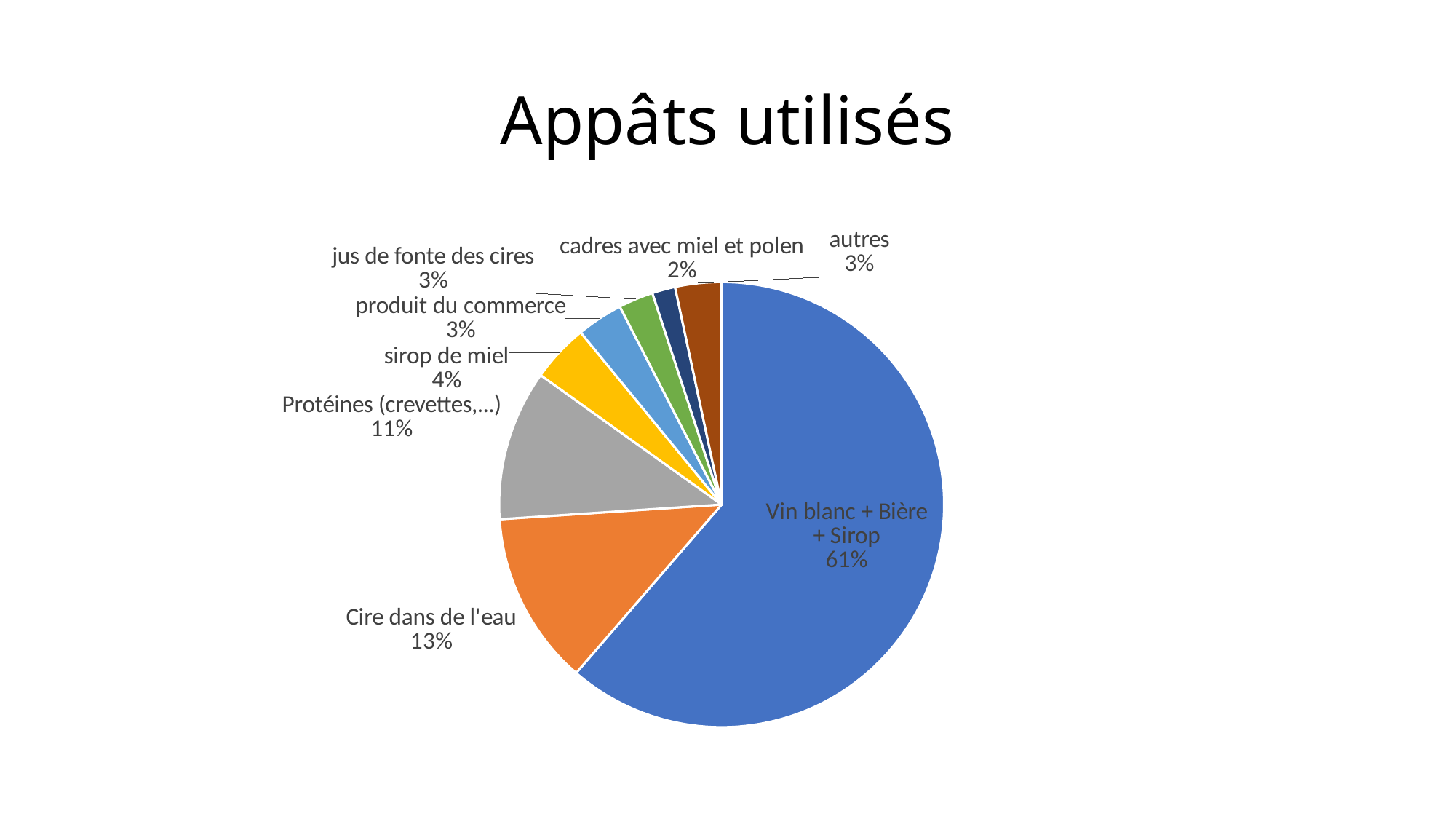
What kind of chart is shown on the slide? pie chart Which category has the largest slice of the pie? Vin blanc + Bière + Sirop What is the difference between the shares of "Cire dans de l'eau" and "Protéines (crevettes,…)"? 2% What is the title of the chart? Appâts utilisés How many slices does the pie chart have? 8 Which is larger, the share for "sirop de miel" or the share for "produit du commerce"? sirop de miel What is the value shown for "Cire dans de l'eau"? 13% What share of the pie does "Vin blanc + Bière + Sirop" represent? 61% What colour is the slice for "Cire dans de l'eau"? orange What is the value shown for "Protéines (crevettes,…)"? 11% Which category has the smallest slice of the pie? cadres avec miel et polen What is the value shown for "sirop de miel"? 4%